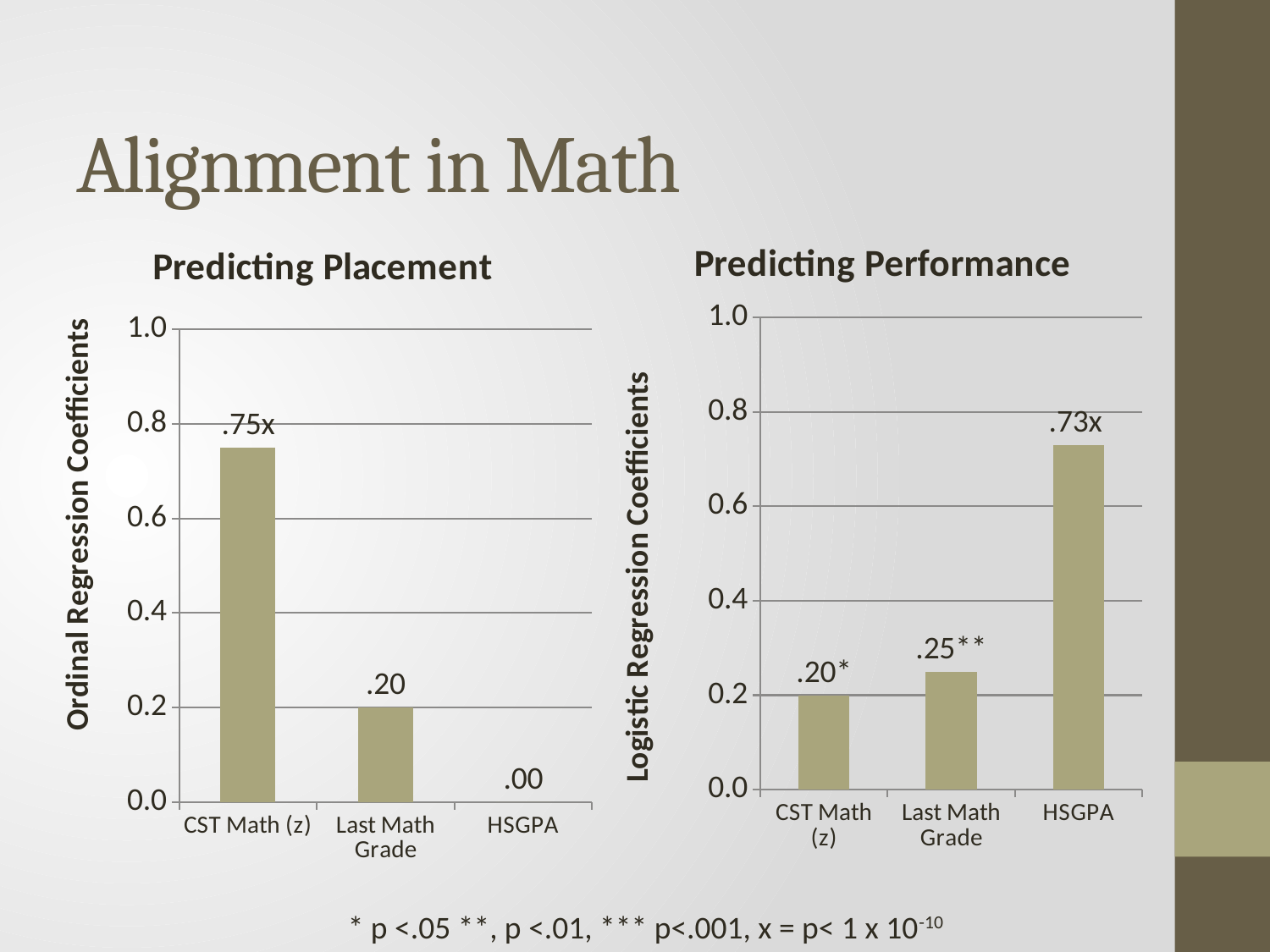
What kind of chart is the Predicting Performance chart? bar chart In the Predicting Performance chart, what is the value for Last Math Grade? .25** In the Predicting Performance chart, is the value for HSGPA greater or less than 0.6? greater In the Predicting Placement chart, which category has the highest value? CST Math (z) How many categories are shown in the Predicting Placement chart? 3 In the Predicting Placement chart, what is the difference between the values for CST Math (z) and Last Math Grade? .55 In the Predicting Placement chart, what is the value for HSGPA? .00 In the Predicting Performance chart, which is larger, the value for HSGPA or the value for Last Math Grade? HSGPA In the Predicting Placement chart, what is the value for Last Math Grade? .20 In the Predicting Performance chart, which category has the lowest value? CST Math (z) In the Predicting Placement chart, what is the value for CST Math (z)? .75x In the Predicting Performance chart, what is the value for HSGPA? .73x